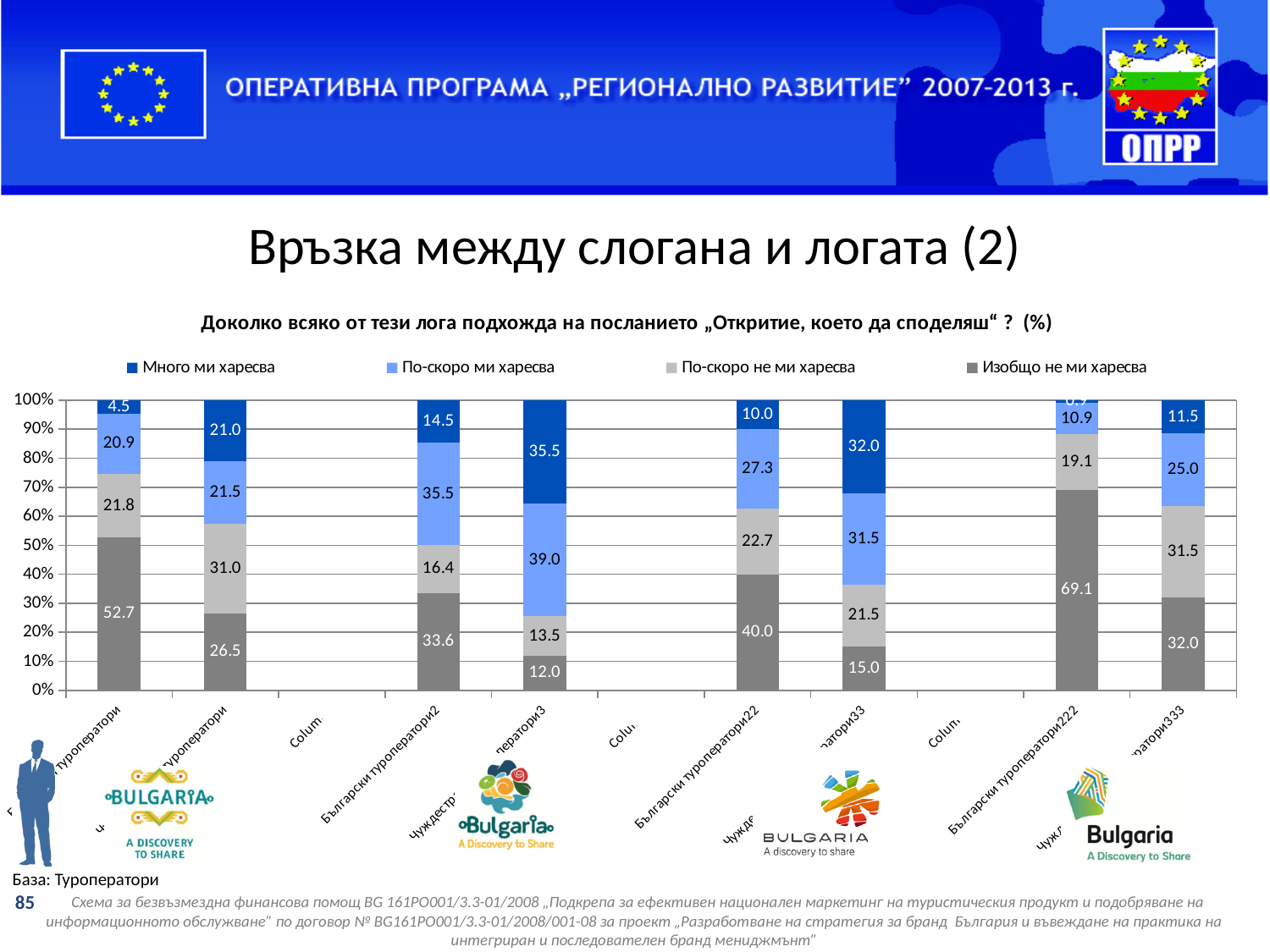
Which has the larger "Изобщо не ми харесва" value: "Български туроператори22" or "Български туроператори222"? Български туроператори222 Among "Български туроператори2", "Български туроператори22" and "Български туроператори222", which has the highest "Изобщо не ми харесва" value? Български туроператори222 For "Български туроператори22", what is the difference between the "По-скоро ми харесва" value and the "По-скоро не ми харесва" value? 4.6 What is the value of "Изобщо не ми харесва" for "Български туроператори2"? 33.6 What is the value of "По-скоро не ми харесва" for "Български туроператори2"? 16.4 How many series does the chart legend list? 4 What kind of chart is shown on the slide? Stacked bar chart What is the value of "Изобщо не ми харесва" for "Български туроператори222"? 69.1 What is the value of "Много ми харесва" for "Български туроператори22"? 10.0 Which has the larger "Много ми харесва" value: "Български туроператори2" or "Български туроператори22"? Български туроператори2 What is the first entry in the chart legend? Много ми харесва What is the value of "По-скоро ми харесва" for "Български туроператори222"? 10.9